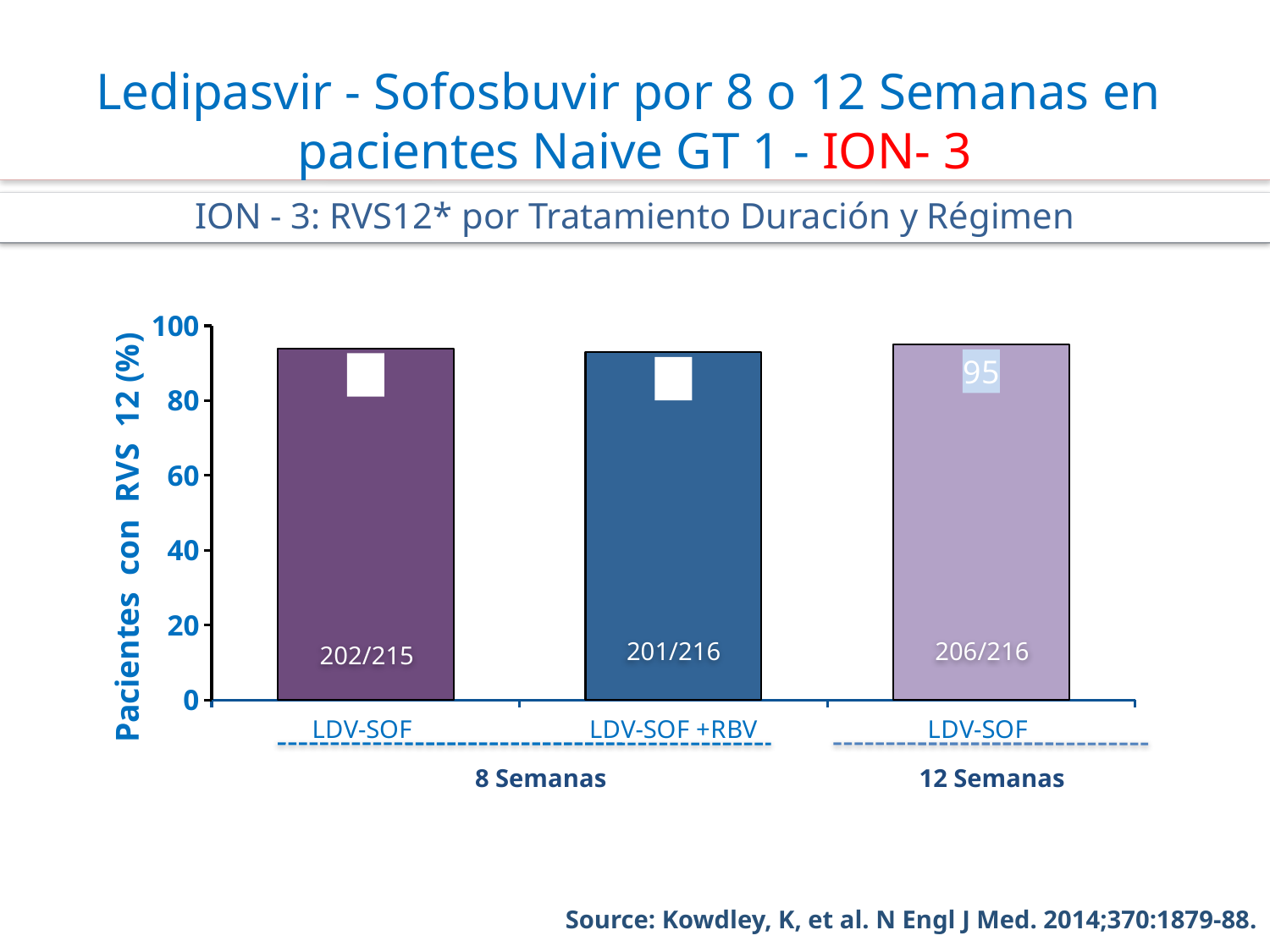
Is the value for LDV-SOF at 12 Semanas greater or less than 100? less What kind of chart is shown on the slide? Bar chart What is the title of the chart? ION - 3: RVS12* por Tratamiento Duración y Régimen Is the value for LDV-SOF +RBV at 8 Semanas greater or less than 60? greater What patient fraction is printed on the LDV-SOF bar in the 12 Semanas group? 206/216 What is the RVS 12 percentage shown for LDV-SOF at 12 Semanas? 95 How many bars are plotted in the chart? 3 What is the title of the y axis? Pacientes con RVS 12 (%) What patient fraction is printed on the LDV-SOF bar in the 8 Semanas group? 202/215 What patient fraction is printed on the LDV-SOF +RBV bar? 201/216 Is the value for LDV-SOF at 8 Semanas greater or less than 80? greater